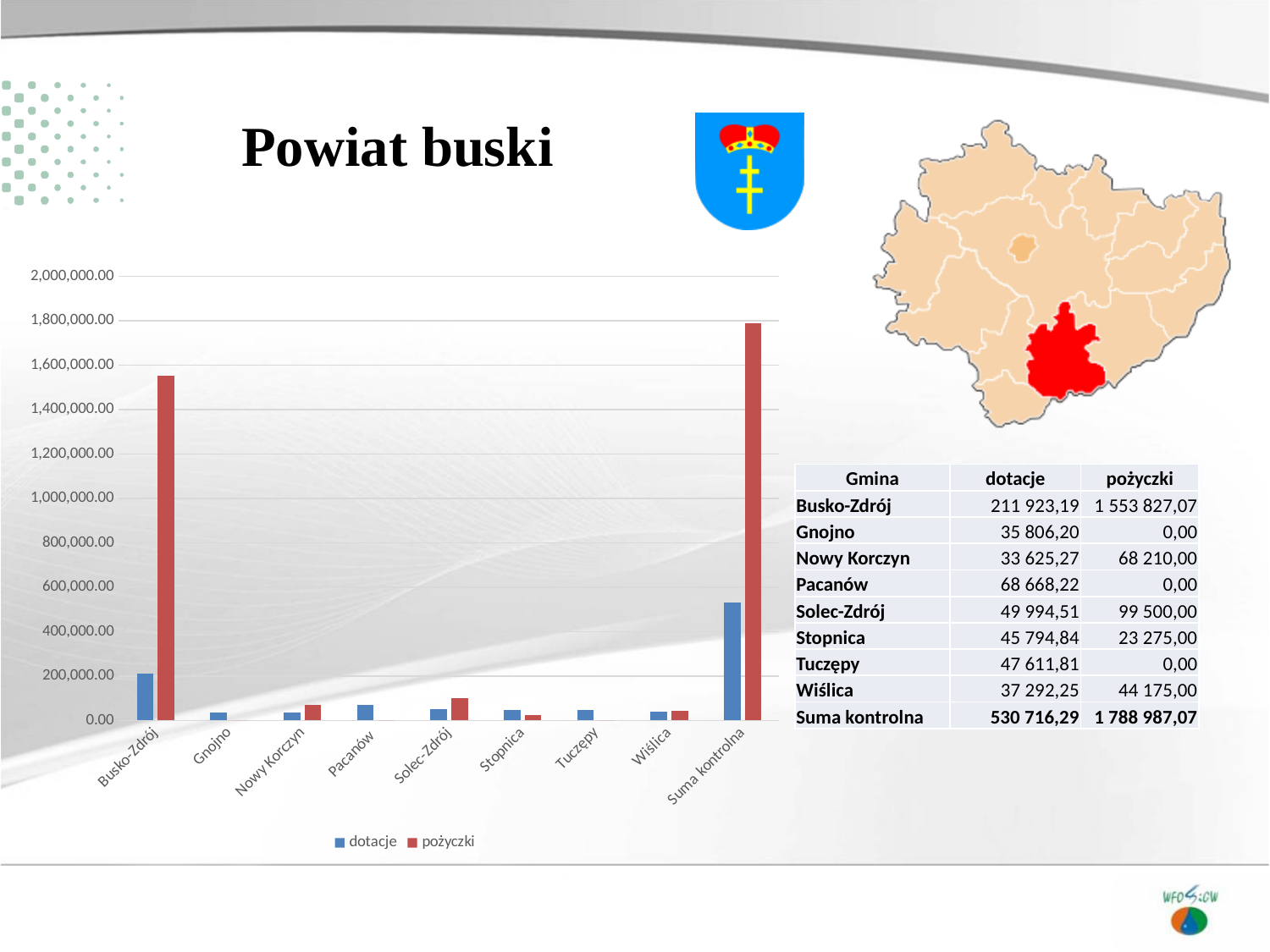
Which is larger for Solec-Zdrój, dotacje or pożyczki? pożyczki Is the pożyczki bar for Busko-Zdrój greater or less than 1,400,000.00? greater Which colour represents the pożyczki series in the chart? red What kind of chart is shown on the slide? bar chart Excluding Suma kontrolna, which gmina has the lowest dotacje value? Nowy Korczyn What is the dotacje value for Suma kontrolna? 530 716,29 What is the dotacje value for Pacanów? 68 668,22 How many series does the chart legend list? 2 What is the pożyczki value for Busko-Zdrój? 1 553 827,07 What is the difference between the pożyczki and dotacje values for Suma kontrolna? 1 258 270,78 How many categories are shown on the x axis of the chart? 9 Excluding Suma kontrolna, which gmina has the highest pożyczki value? Busko-Zdrój